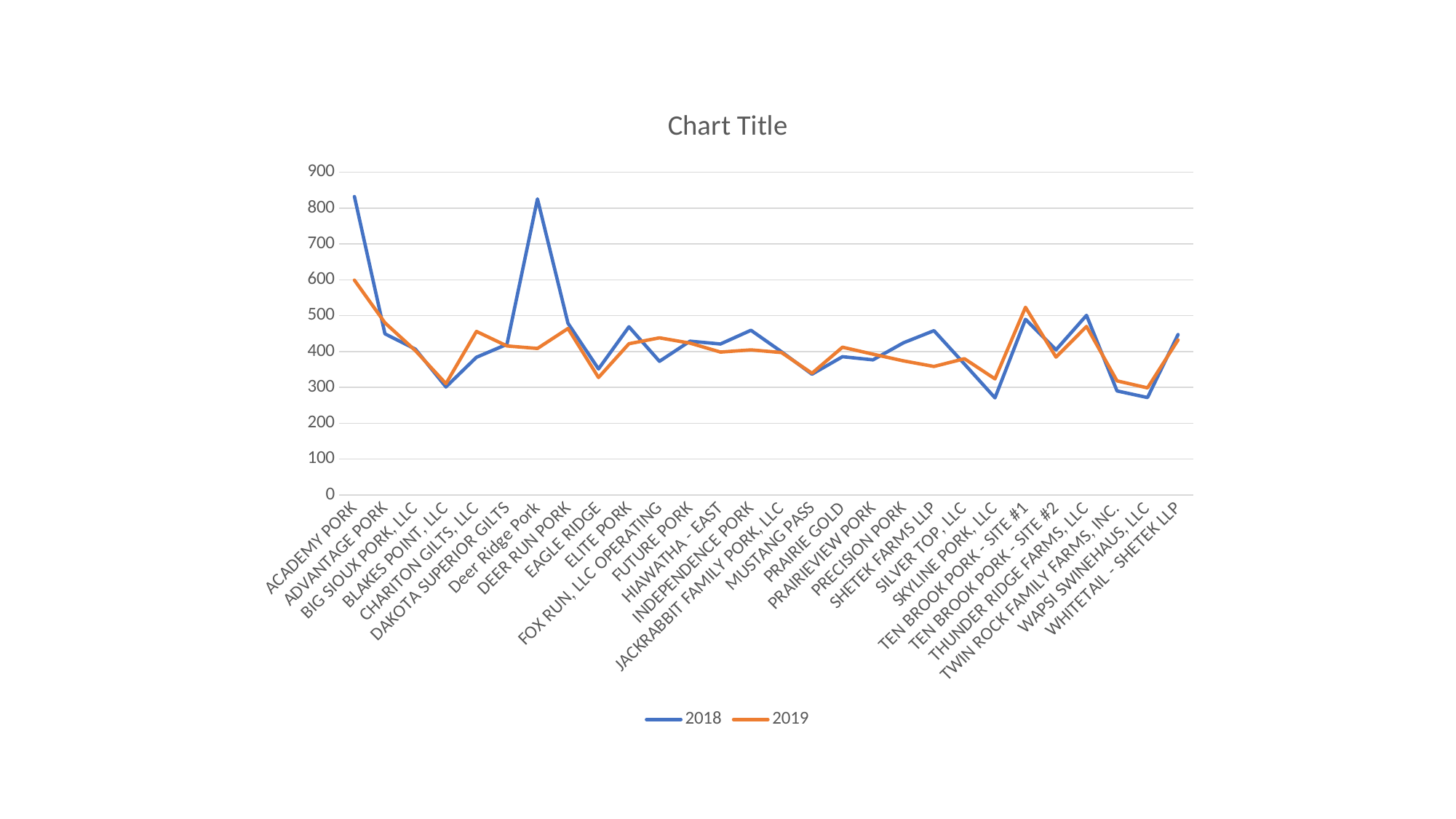
Is the 2019 value for Deer Ridge Pork greater or less than 500? less How many series does the legend list? 2 For CHARITON GILTS, LLC, which series has the larger value, 2018 or 2019? 2019 Is the 2019 value for EAGLE RIDGE greater or less than 400? less Which series are listed in the legend? 2018 and 2019 What kind of chart is shown on the slide? line chart For Deer Ridge Pork, which series has the larger value, 2018 or 2019? 2018 Which category has the highest value for the 2019 series? ACADEMY PORK Is the 2018 value for Deer Ridge Pork greater or less than 700? greater How many categories are plotted along the x axis? 28